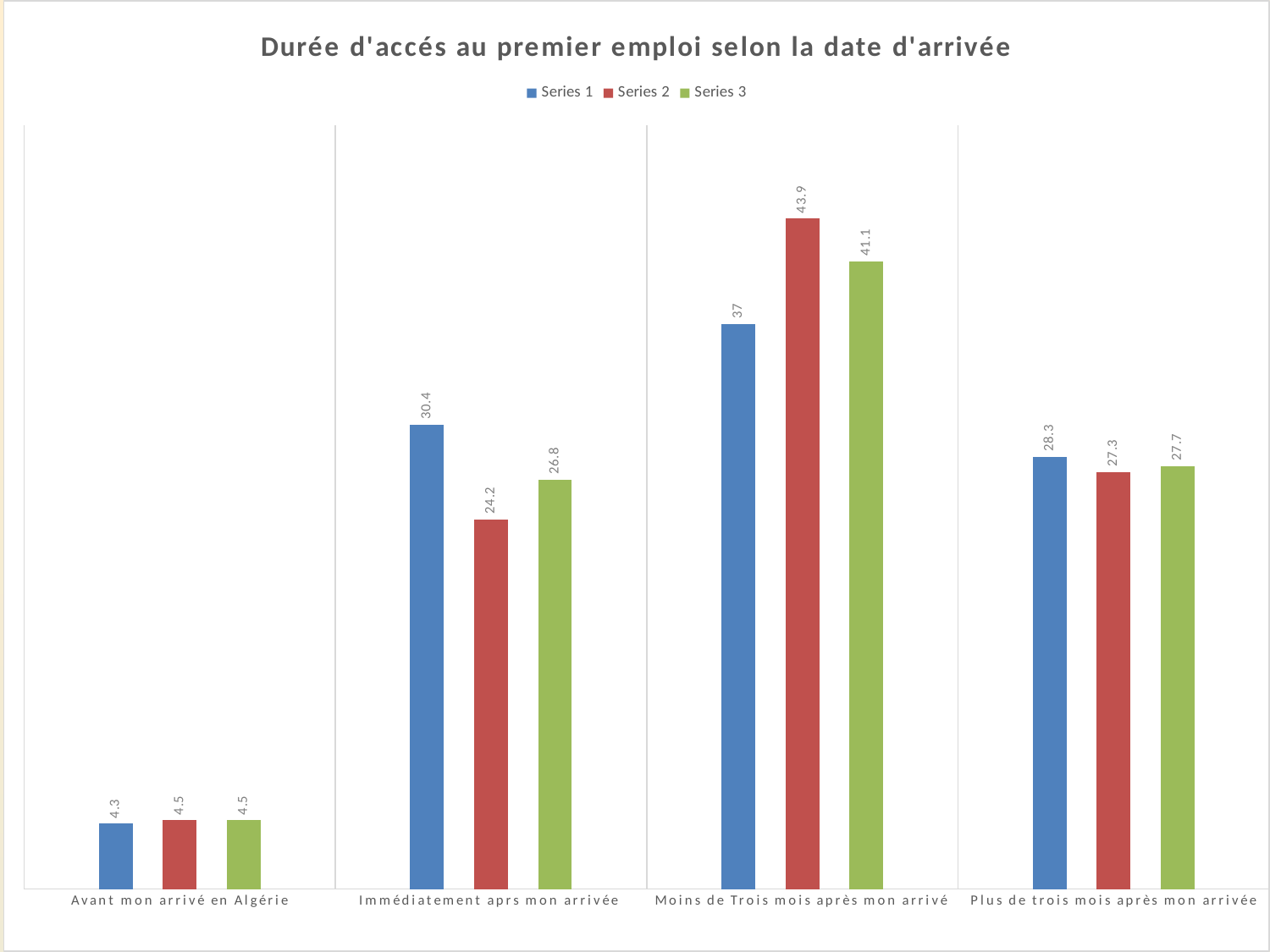
How many categories are shown on the x axis? 4 What is the value of Series 2 for "Immédiatement aprs mon arrivée"? 24.2 What is the title of the chart? Durée d'accés au premier emploi selon la date d'arrivée What is the value of Series 1 for "Avant mon arrivé en Algérie"? 4.3 What is the value of Series 3 for "Plus de trois mois après mon arrivée"? 27.7 Which category has the lowest value for Series 3? Avant mon arrivé en Algérie What is the difference between Series 2 and Series 1 for "Moins de Trois mois après mon arrivé"? 6.9 For "Immédiatement aprs mon arrivée", which is larger: Series 1 or Series 3? Series 1 How many series does the legend list? 3 What is the value of Series 1 for "Moins de Trois mois après mon arrivé"? 37 What kind of chart is shown on the slide? Bar chart Which category has the highest value for Series 2? Moins de Trois mois après mon arrivé